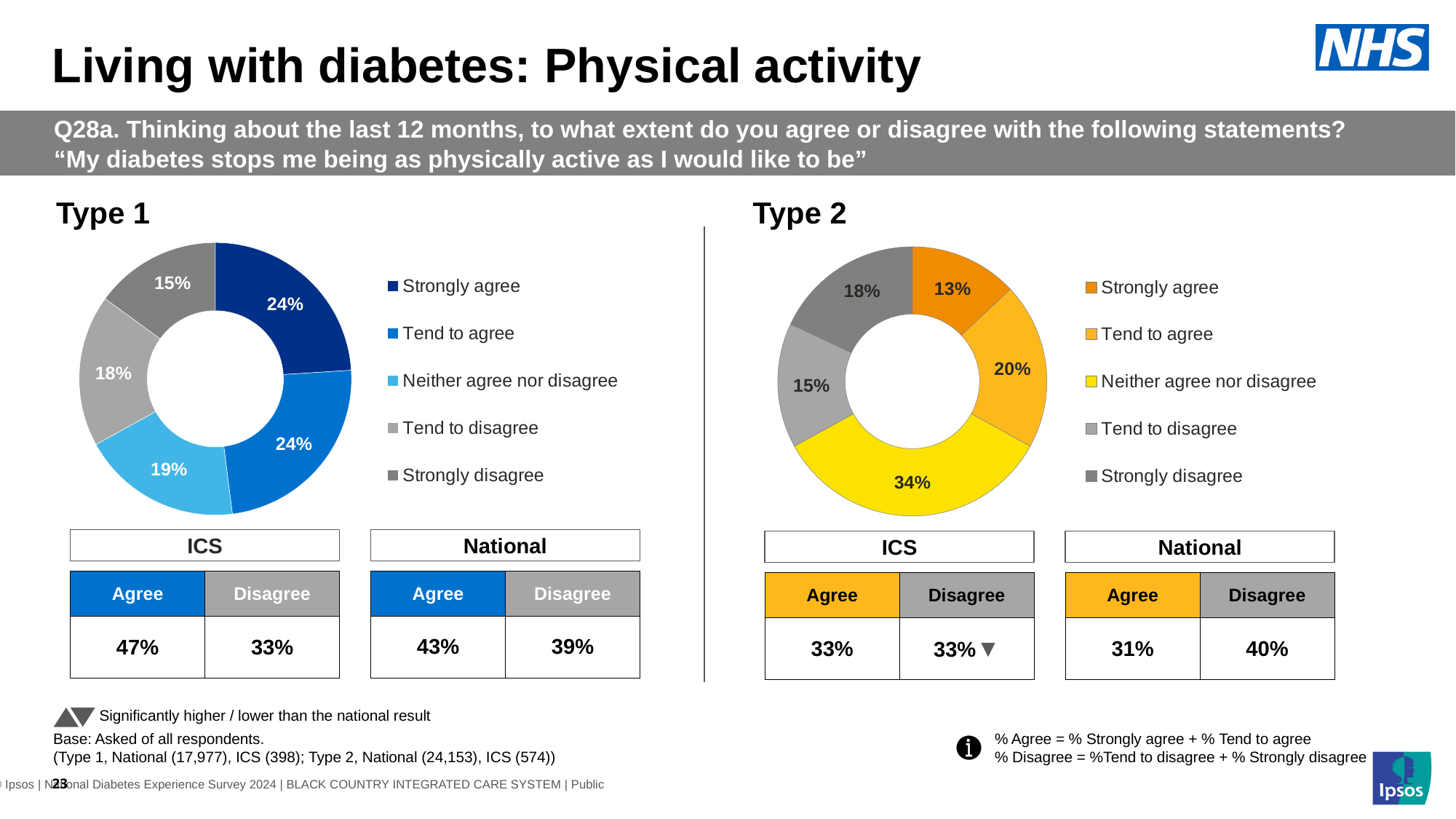
In the Type 2 chart, which is larger: 'Strongly disagree' or 'Tend to disagree'? Strongly disagree In the Type 1 chart, what percentage of respondents said 'Neither agree nor disagree'? 19% In the Type 1 chart, what is the difference in percentage points between 'Strongly agree' and 'Strongly disagree'? 9 What kind of chart is used for the Type 2 results? Donut chart In the Type 2 chart, what is the difference in percentage points between 'Neither agree nor disagree' and 'Strongly agree'? 21 In the Type 2 chart, what colour represents 'Neither agree nor disagree'? Yellow In the Type 2 chart, which response category has the largest share? Neither agree nor disagree How many response categories does the Type 1 chart show? 5 In the Type 1 chart, what percentage of respondents said 'Tend to disagree'? 18% In the Type 1 chart, which response category has the smallest share? Strongly disagree In the Type 2 chart, which response category has the smallest share? Strongly agree In the Type 2 chart, what percentage of respondents said 'Tend to agree'? 20%